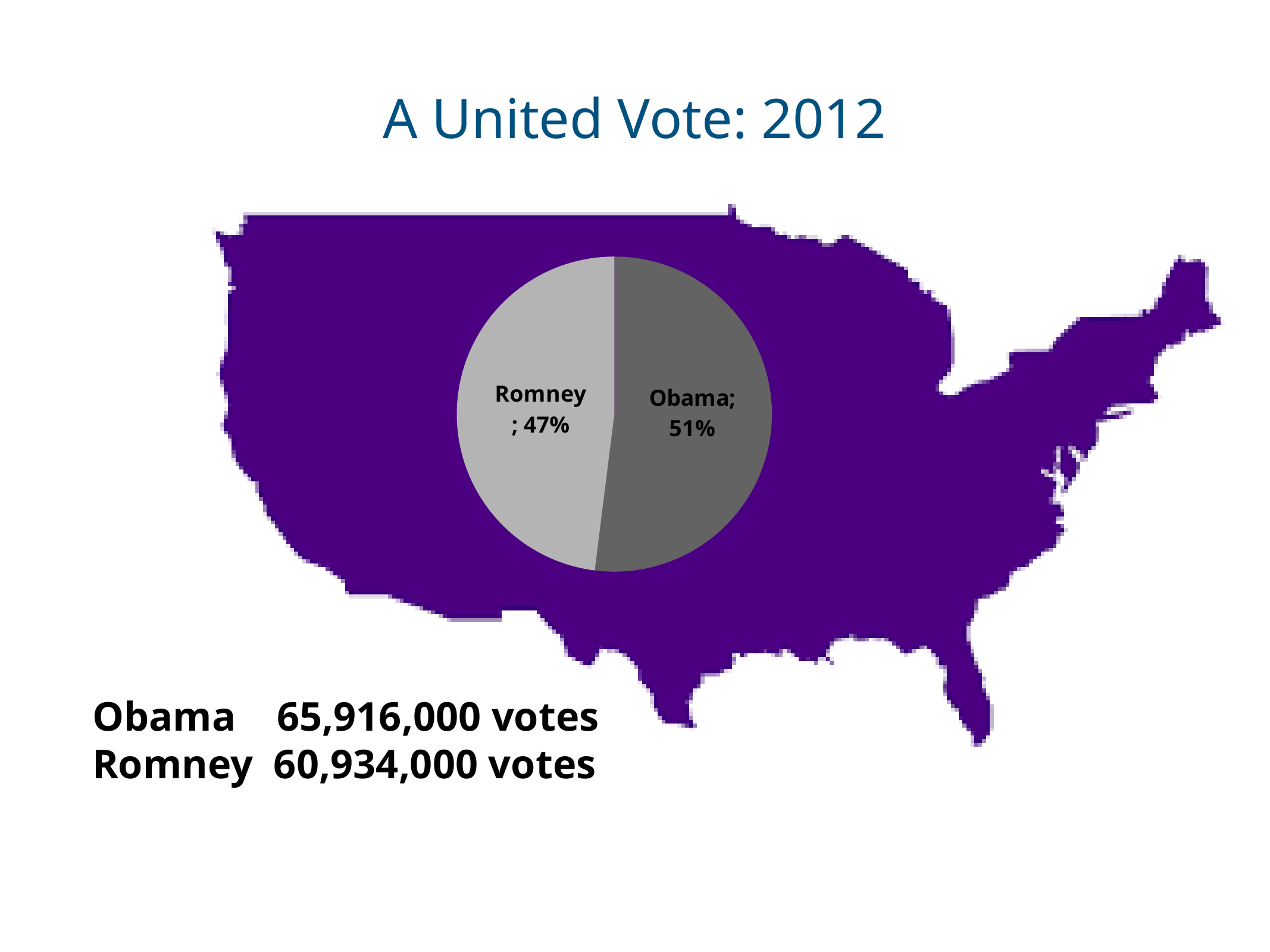
According to the text on the slide, how many votes did Romney receive? 60,934,000 votes What is the title of the slide containing the pie chart? A United Vote: 2012 Which slice of the pie is the largest? Obama According to the text on the slide, how many votes did Obama receive? 65,916,000 votes Which slice is larger, Obama or Romney? Obama Which slice of the pie is shown in the darker grey colour? Obama How many slices does the pie chart have? 2 What percentage of the pie is labelled for Obama? 51% What percentage of the pie is labelled for Romney? 47% Which slice of the pie is the smallest? Romney What kind of chart is shown on the slide? Pie chart What is the difference in percentage points between the Obama slice and the Romney slice? 4 percentage points